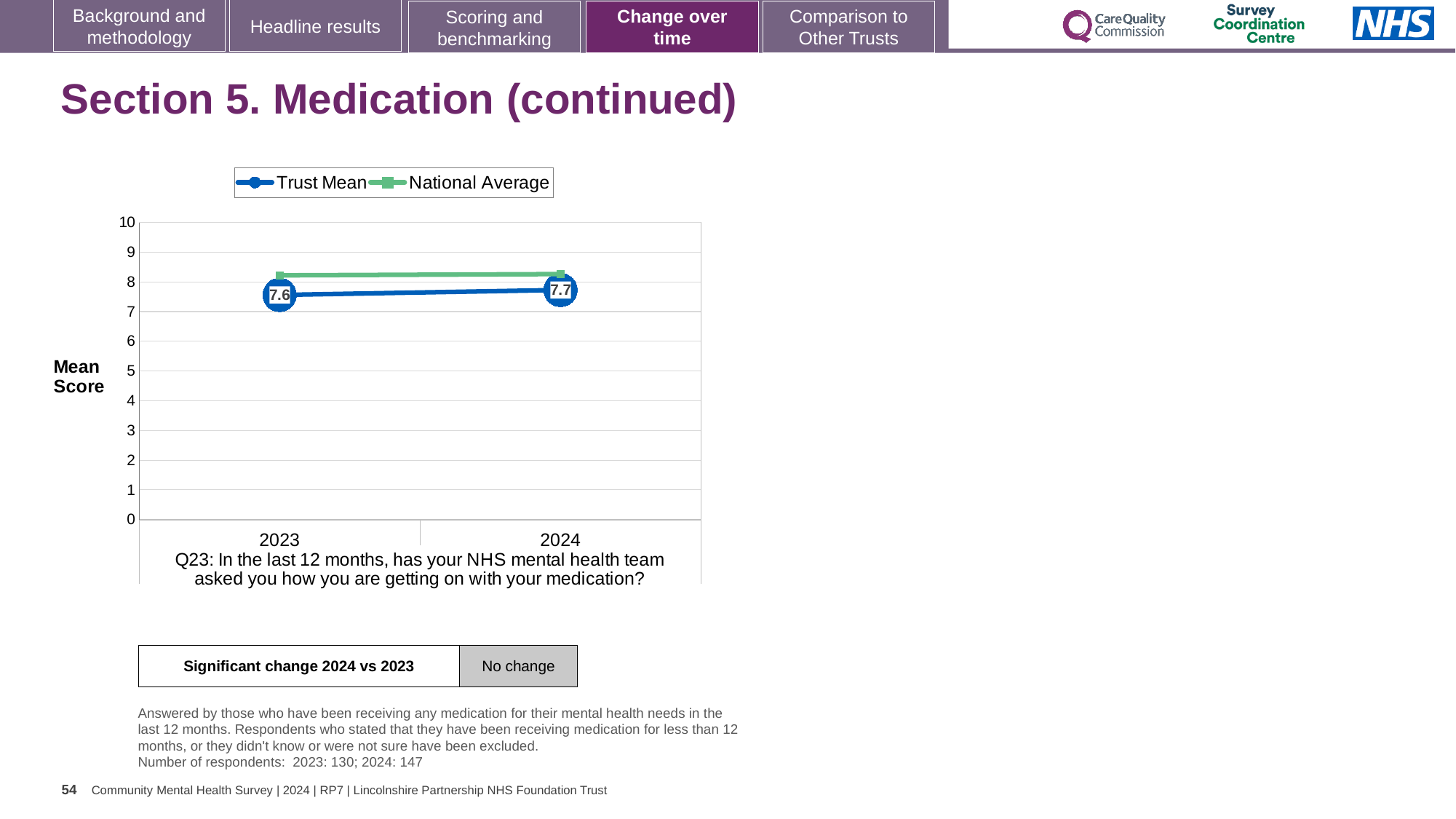
Is the National Average value for 2023 greater or less than 9? less Does the Trust Mean rise or fall from 2023 to 2024? Rise What is the Trust Mean value for 2023? 7.6 What is the Trust Mean value for 2024? 7.7 What kind of chart is shown on the slide? Line chart How many years are shown on the x axis of the chart? 2 How many series does the chart legend list? 2 Is the National Average value for 2024 greater or less than 7? greater Which year has the higher Trust Mean, 2023 or 2024? 2024 In 2024, which series is higher, Trust Mean or National Average? National Average What is the label on the y axis of the chart? Mean Score What is the difference between the Trust Mean in 2024 and in 2023? 0.1